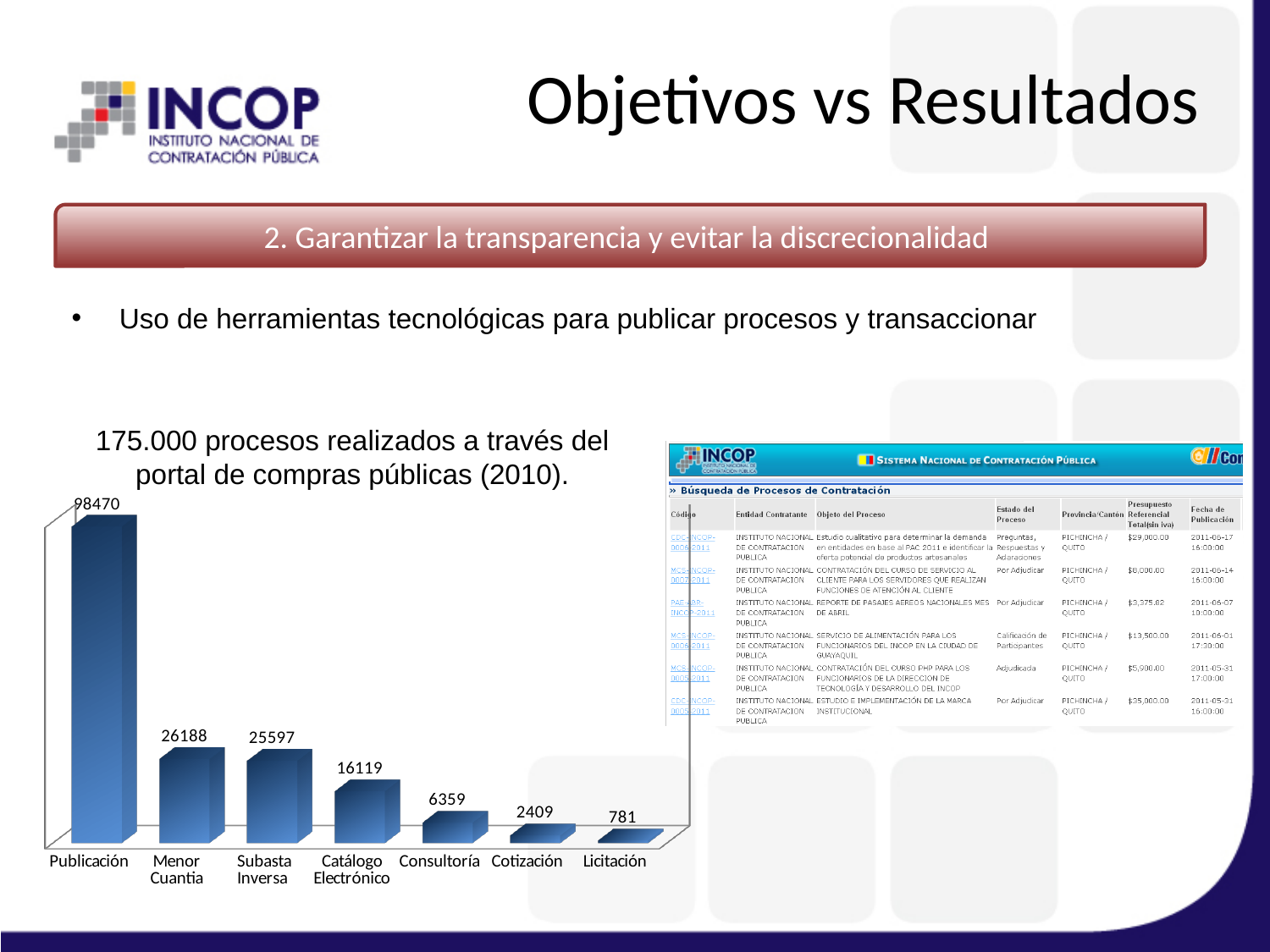
What kind of chart is shown on the slide? Bar chart What is the value for Catálogo Electrónico in the bar chart? 16119 Which is larger, the value for Catálogo Electrónico or the value for Consultoría? Catálogo Electrónico What is the difference between the values for Menor Cuantia and Subasta Inversa? 591 Which category has the highest value in the bar chart? Publicación Which category has the lowest value in the bar chart? Licitación How many categories are shown in the bar chart? 7 What is the value for Publicación in the bar chart? 98470 Do the values in the bar chart rise or fall from left to right? Fall What is the value for Licitación in the bar chart? 781 What is the value for Consultoría in the bar chart? 6359 What is the difference between the values for Cotización and Licitación? 1628